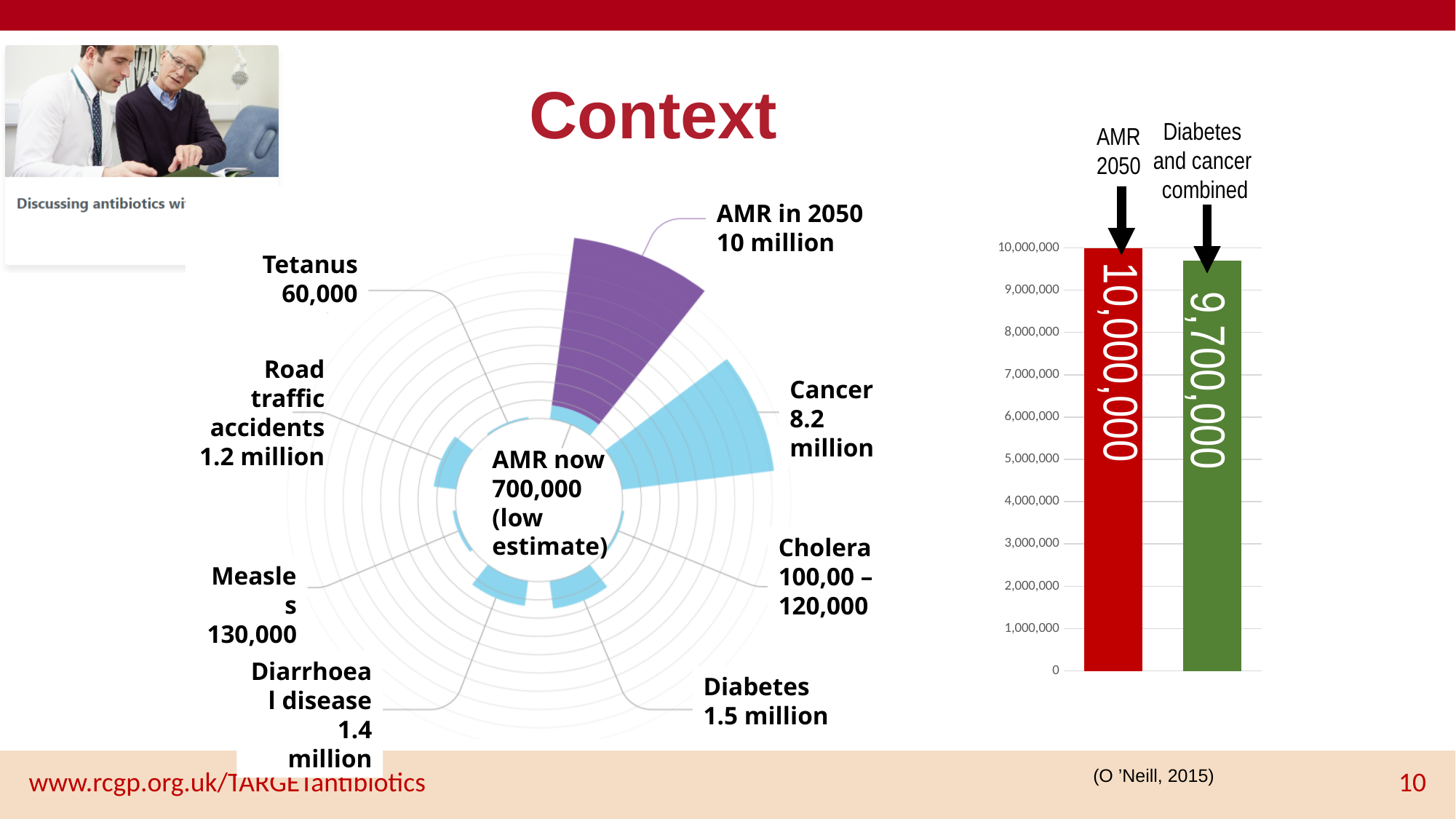
In the radial chart on the left, what value is given for AMR now (low estimate)? 700,000 How many bars are shown in the bar chart on the right? 2 In the bar chart on the right, what colour is the AMR 2050 bar? Red In the bar chart on the right, what is the value for Diabetes and cancer combined? 9,700,000 In the radial chart on the left, what value is given for Cancer? 8.2 million In the bar chart on the right, what is the difference between the AMR 2050 bar and the Diabetes and cancer combined bar? 300,000 In the radial chart on the left, which category has the largest value? AMR in 2050 In the radial chart on the left, which category has the smallest value? Tetanus In the radial chart on the left, what value is given for Tetanus? 60,000 What kind of chart is shown on the right side of the slide? Bar chart In the bar chart on the right, which bar is taller: AMR 2050 or Diabetes and cancer combined? AMR 2050 In the bar chart on the right, what is the value for AMR 2050? 10,000,000